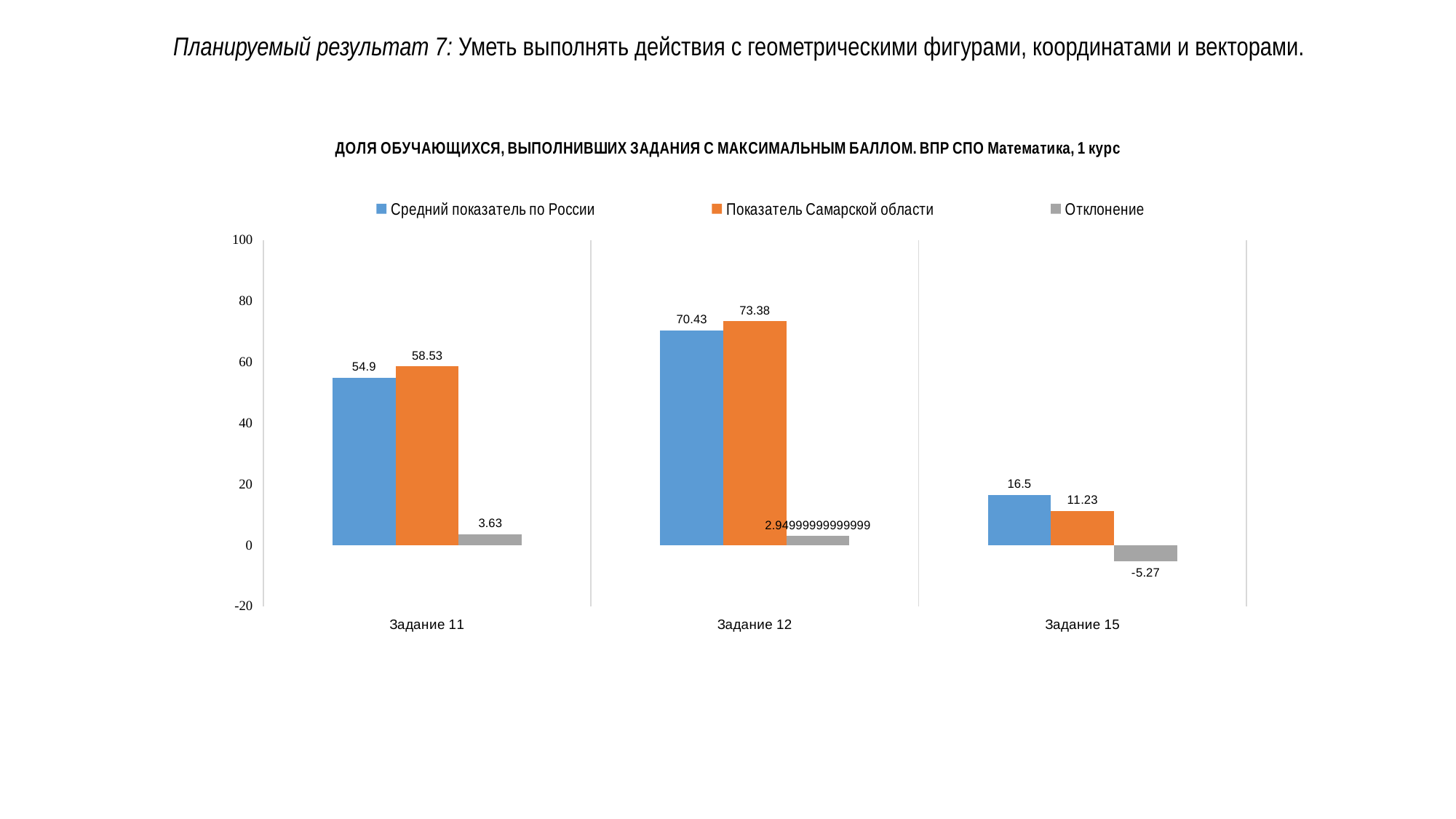
What is the value of Средний показатель по России for Задание 11? 54.9 What is the value of Отклонение for Задание 15? -5.27 How many series does the legend list? 3 What kind of chart is shown on the slide? Bar chart What is the value of Показатель Самарской области for Задание 15? 11.23 What is the difference between Показатель Самарской области and Средний показатель по России for Задание 11? 3.63 Which category has the highest value for Средний показатель по России? Задание 12 What is the value of Показатель Самарской области for Задание 12? 73.38 Which category has the lowest value for Показатель Самарской области? Задание 15 For Задание 15, which is larger: Средний показатель по России or Показатель Самарской области? Средний показатель по России Which series is shown in orange? Показатель Самарской области How many categories are shown on the x axis? 3